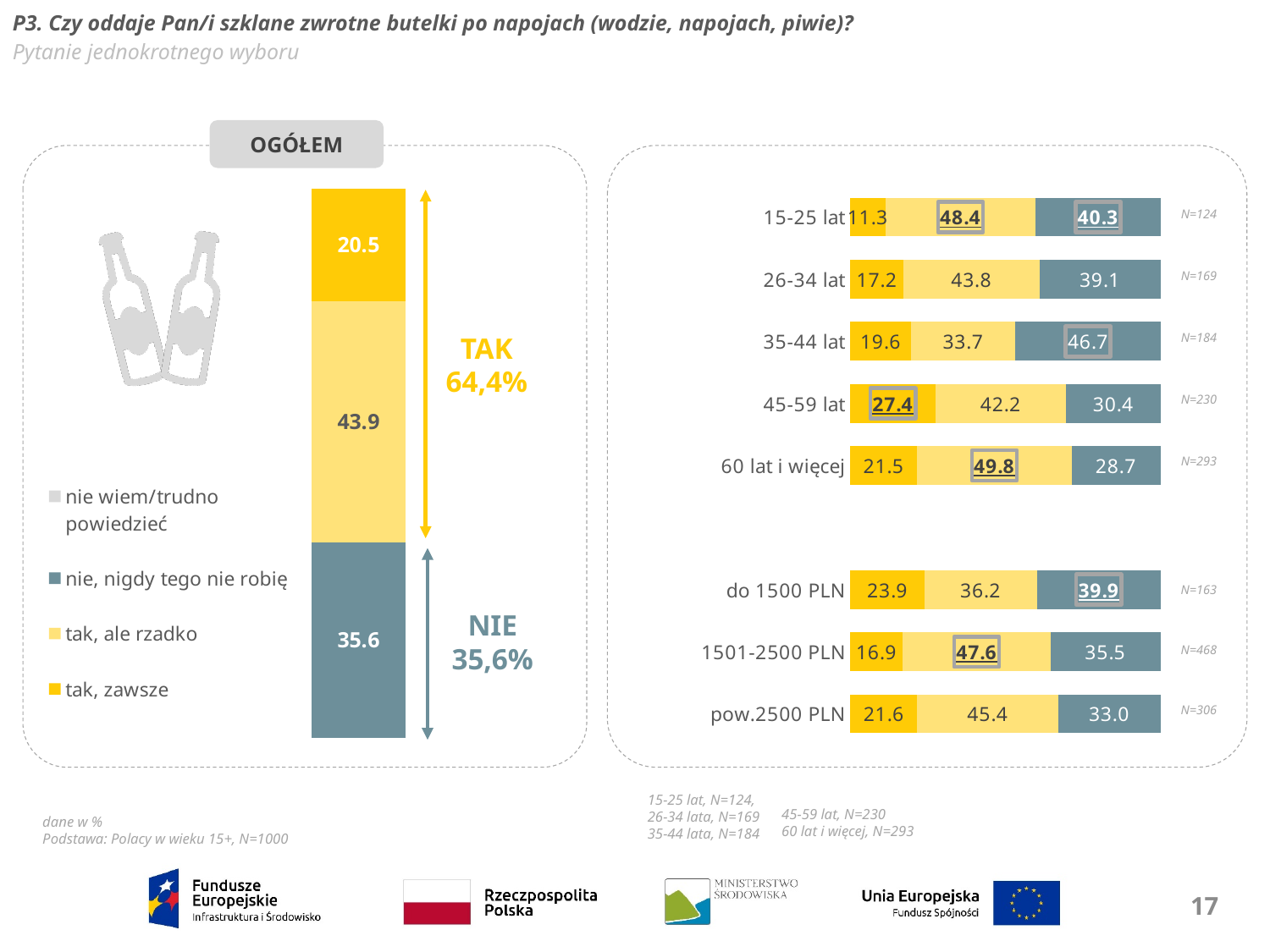
On the OGÓŁEM chart on the left, what is the value for "nie, nigdy tego nie robię"? 35.6 How many series does the legend of the OGÓŁEM chart on the left list? 4 On the chart on the right, what is the difference in "tak, ale rzadko" between the 1501-2500 PLN group and the do 1500 PLN group? 11.4 On the OGÓŁEM chart on the left, which segment is the largest? tak, ale rzadko On the chart on the right, what is the value for "tak, zawsze" in the 45-59 lat group? 27.4 On the OGÓŁEM chart on the left, what percentage is labelled TAK? 64,4% What kind of chart is the OGÓŁEM chart on the left? bar chart On the chart on the right, what is the value for "nie, nigdy tego nie robię" in the 35-44 lat group? 46.7 On the OGÓŁEM chart on the left, what is the difference between "tak, ale rzadko" and "nie, nigdy tego nie robię"? 8.3 How many groups (bars) are shown on the chart on the right? 8 On the chart on the right, which group has the lowest value for "tak, zawsze"? 15-25 lat On the OGÓŁEM chart on the left, what is the value for "tak, ale rzadko"? 43.9